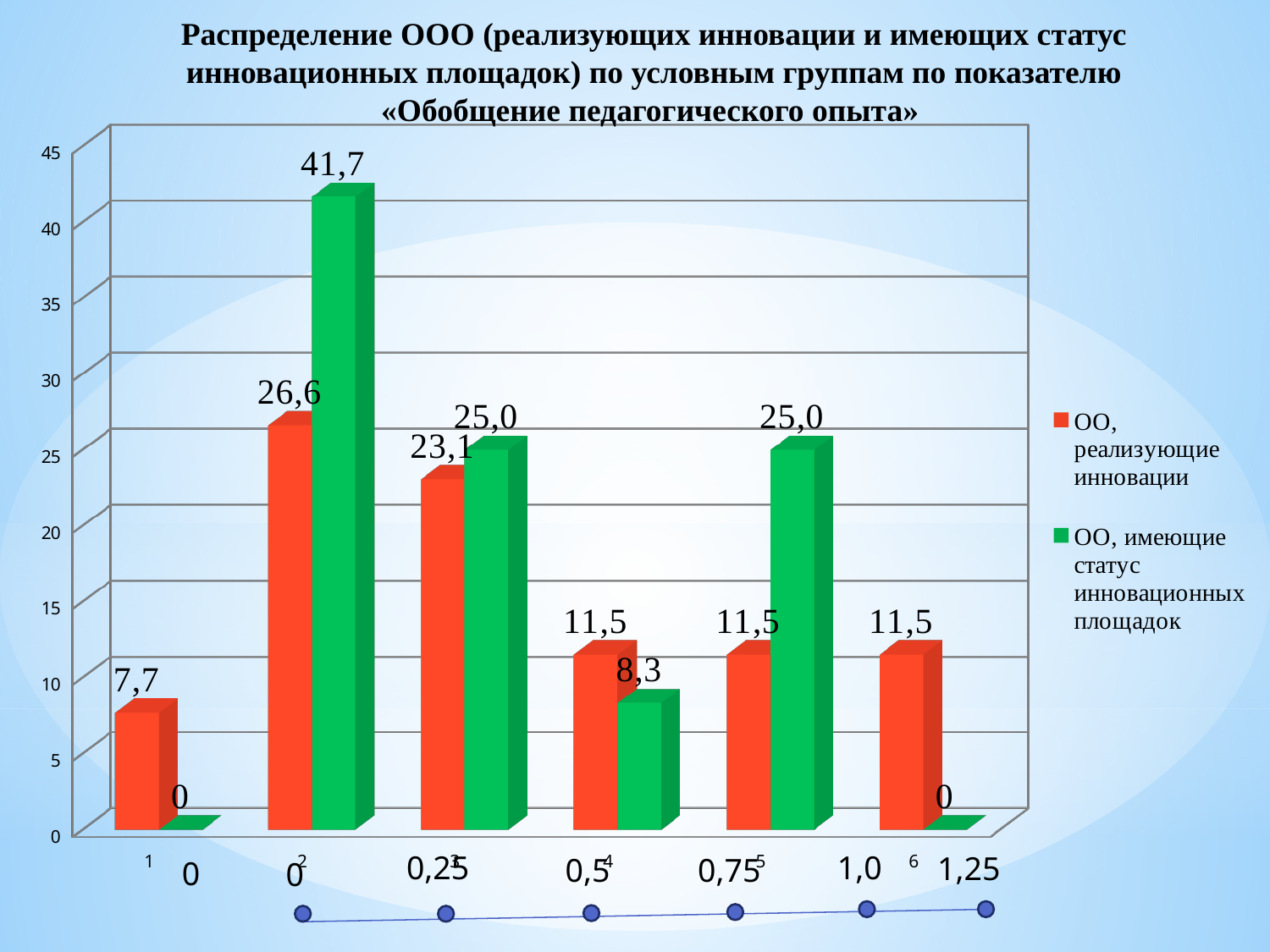
For category 4, which series has the larger value: «ОО, реализующие инновации» or «ОО, имеющие статус инновационных площадок»? ОО, реализующие инновации For which category is the series «ОО, имеющие статус инновационных площадок» highest? 2 What is the value of the series «ОО, имеющие статус инновационных площадок» for category 6? 0 What kind of chart is shown on the slide? bar chart What is the value of the series «ОО, имеющие статус инновационных площадок» for category 2? 41,7 For category 3, what is the difference between the value for «ОО, имеющие статус инновационных площадок» and the value for «ОО, реализующие инновации»? 1,9 What is the value of the series «ОО, реализующие инновации» for category 1? 7,7 How many series does the legend list? 2 How many categories are shown on the x axis of the chart? 6 What is the value of the series «ОО, реализующие инновации» for category 2? 26,6 For category 2, what is the difference between the value for «ОО, имеющие статус инновационных площадок» and the value for «ОО, реализующие инновации»? 15,1 For which category is the series «ОО, реализующие инновации» lowest? 1